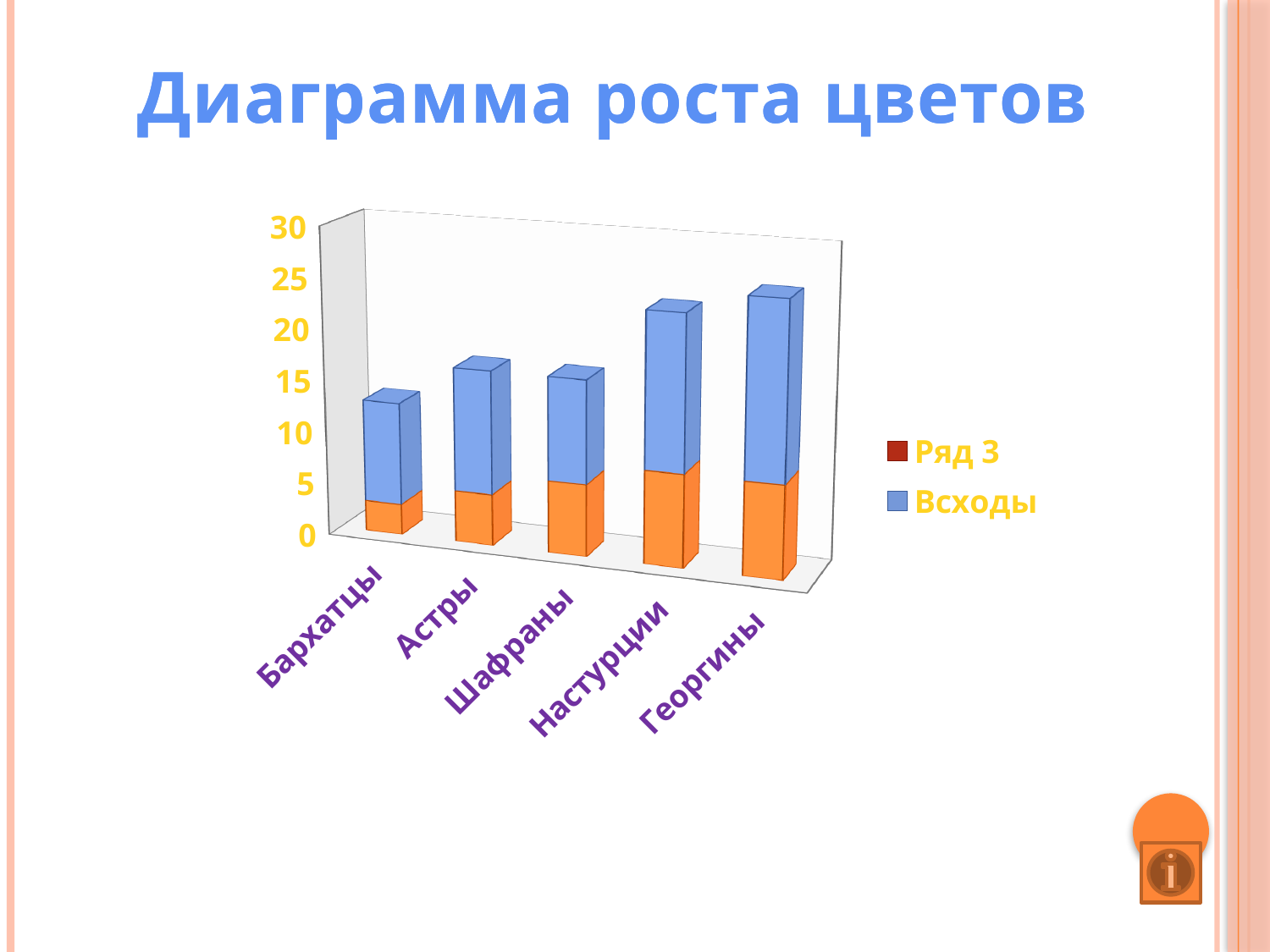
Which category has the tallest bar? Георгины What is the title of the chart? Диаграмма роста цветов Is the total bar height for Бархатцы greater or less than 15? less What are the two series names listed in the legend? Ряд 3 and Всходы Which category has the shortest bar? Бархатцы Which bar is taller, Бархатцы or Георгины? Георгины Is the total bar height for Бархатцы greater or less than 10? greater Which bar is taller, Настурции or Астры? Настурции How many flower categories are shown on the x axis? 5 Is the total bar height for Георгины greater or less than 20? greater How many series does the legend list? 2 What kind of chart is shown on the slide? Bar chart